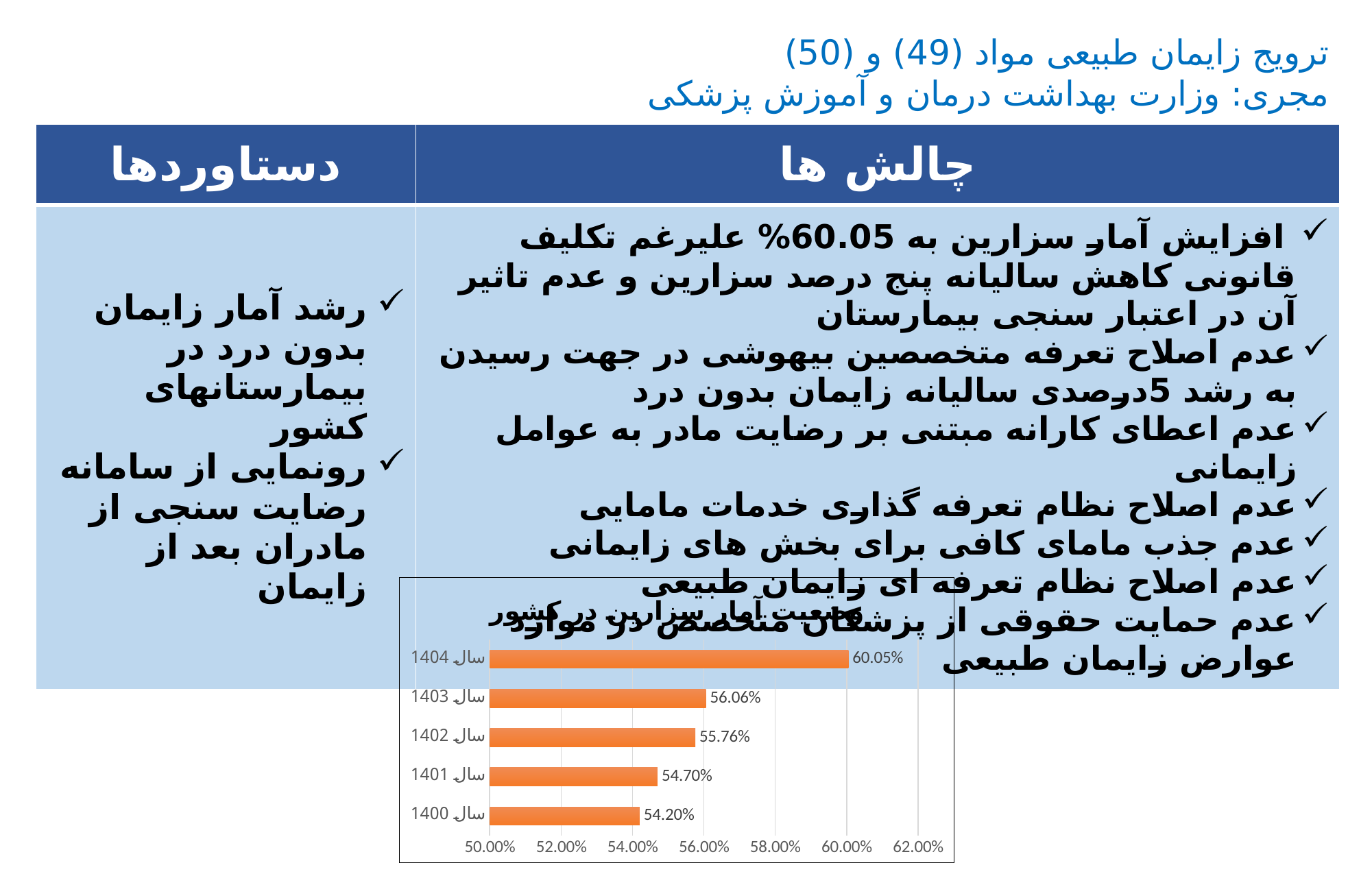
How many years are shown in the chart? 5 What kind of chart is shown on the slide? bar chart Which year has the highest value? سال 1404 Is the value for سال 1404 greater or less than 58.00%? greater Which is larger, the value for سال 1403 or the value for سال 1402? سال 1403 What is the value for سال 1401? 54.70% Which year has the lowest value? سال 1400 What is the value for سال 1400? 54.20% What is the value for سال 1404? 60.05% What is the value for سال 1402? 55.76% What is the difference between the values for سال 1401 and سال 1400? 0.50% What is the difference between the values for سال 1404 and سال 1403? 3.99%